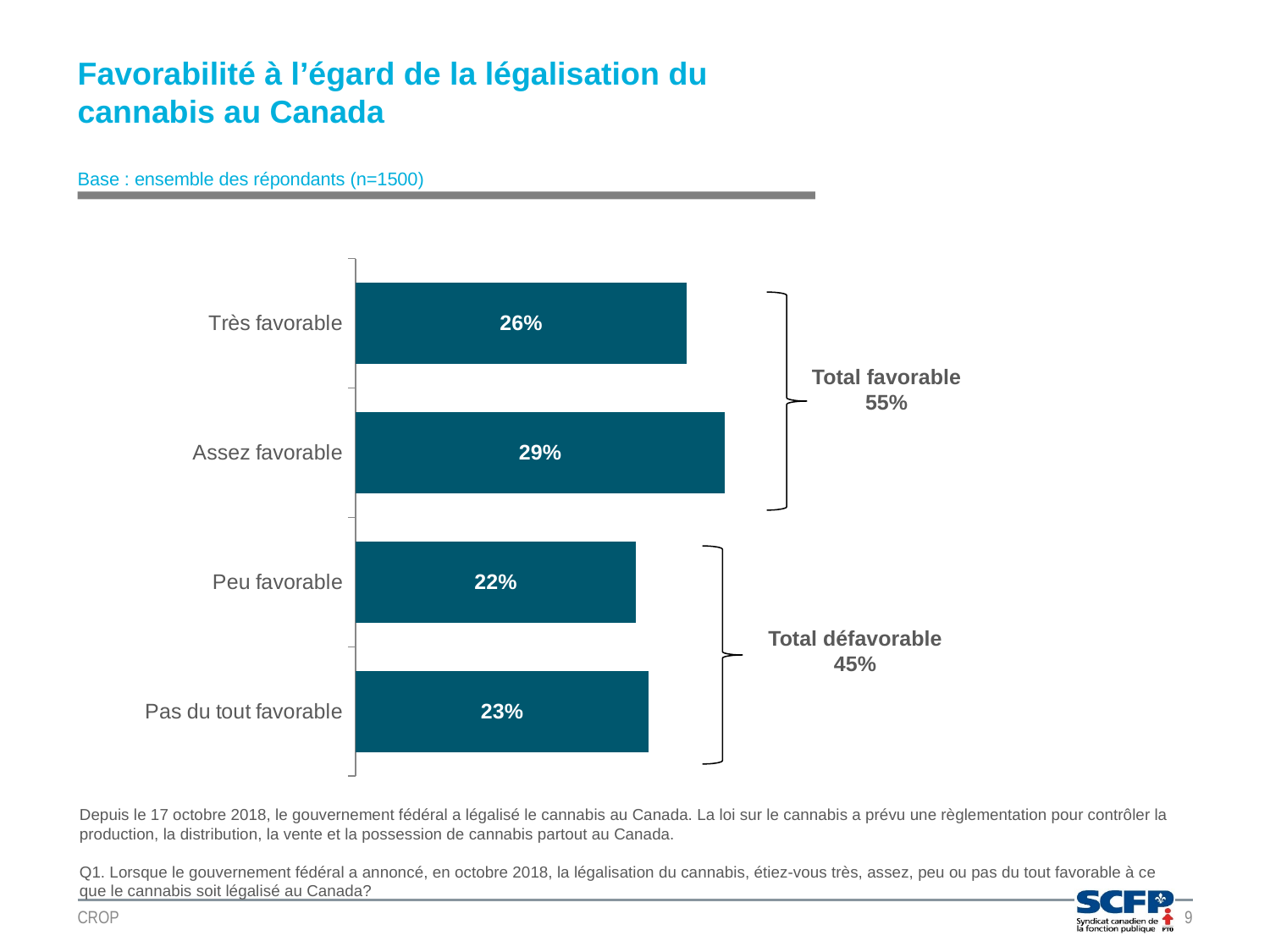
Which is larger, "Très favorable" or "Pas du tout favorable"? Très favorable What is the "Total favorable" percentage shown next to the chart? 55% What kind of chart is shown on the slide? Bar chart What is the "Total défavorable" percentage shown next to the chart? 45% What is the difference between "Assez favorable" and "Peu favorable"? 7% What is the value for "Pas du tout favorable"? 23% What is the value for "Assez favorable"? 29% What is the value for "Très favorable"? 26% Which category has the highest value? Assez favorable What is the value for "Peu favorable"? 22% Which category has the lowest value? Peu favorable How many categories are shown in the chart? 4